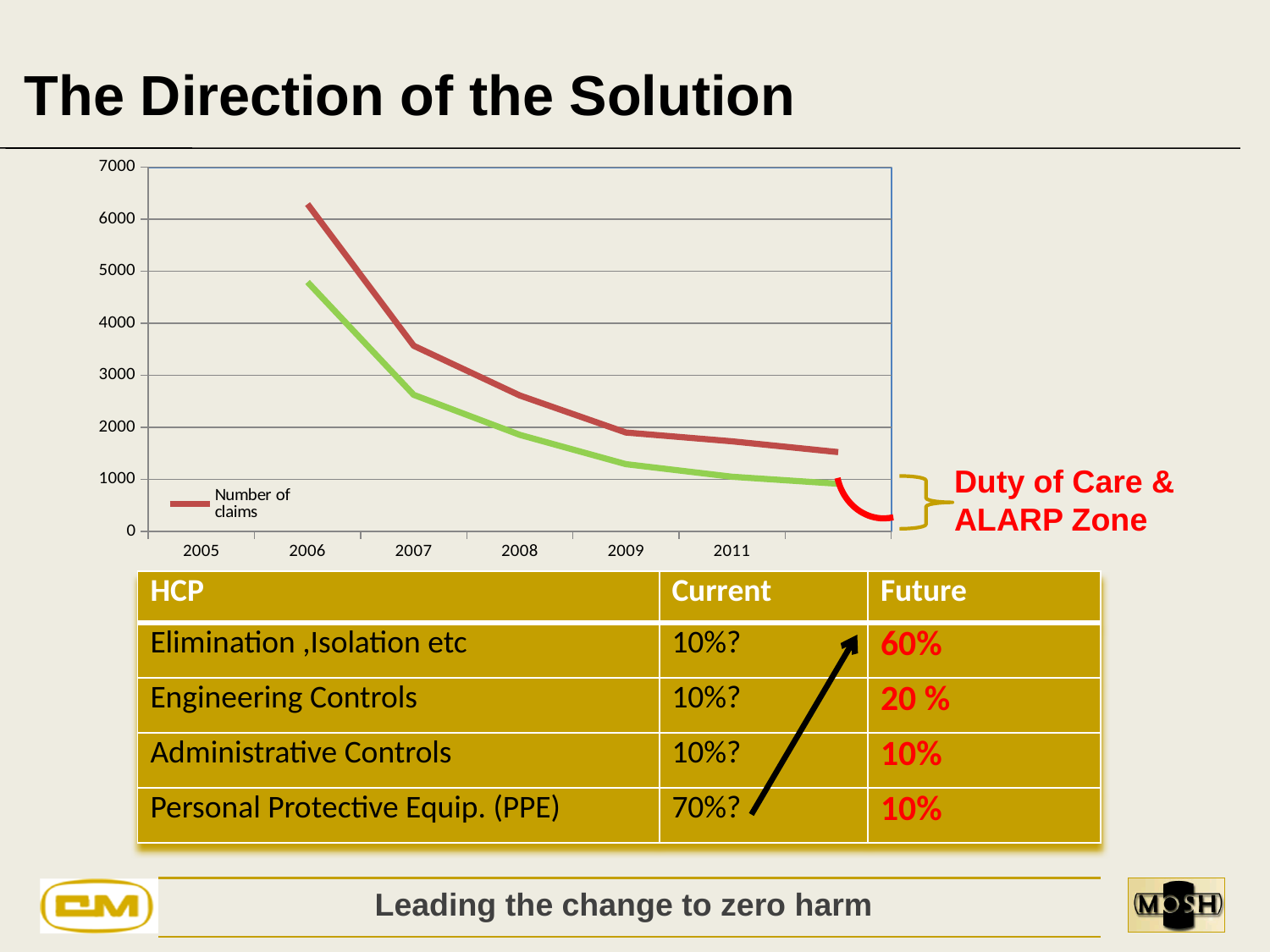
At 2008, which line has the larger value, the red line or the green line? the red line How many series entries does the legend list? 1 In which year does the red 'Number of claims' line reach its highest value? 2006 Is the value of the red 'Number of claims' line at 2011 greater or less than 2000? less Is the value of the green line at 2007 greater or less than 3000? less Is the value of the red 'Number of claims' line at 2006 greater or less than 5000? greater What is the title of the slide containing the chart? The Direction of the Solution What series name does the chart's legend show? Number of claims What kind of chart is shown on the slide? line chart How many year labels are shown on the x axis? 6 Do the values of the red 'Number of claims' line rise or fall from 2006 to 2011? fall